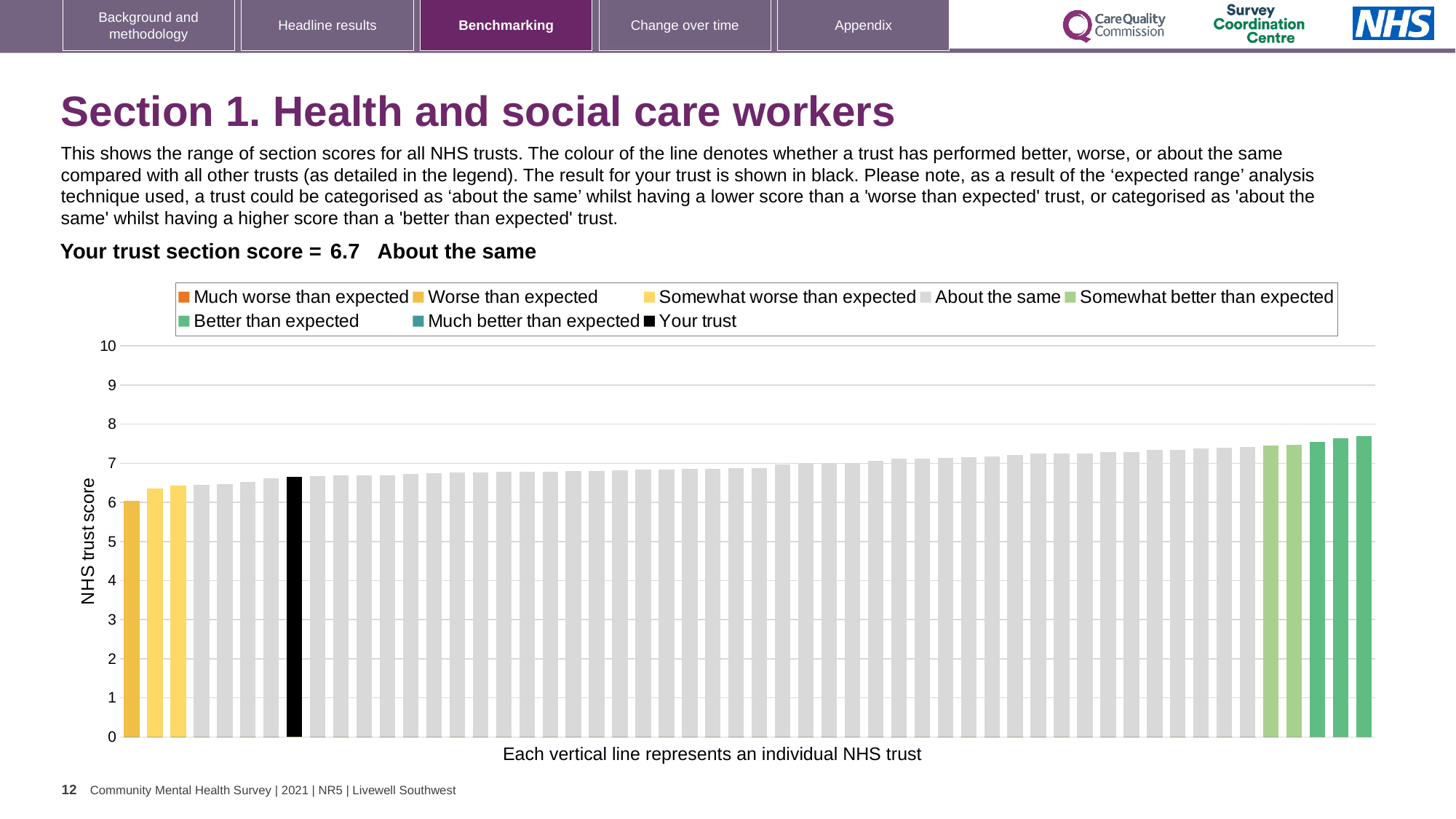
How many bars are coloured as 'Worse than expected' (yellow)? 1 Which category does your trust fall into according to the slide? About the same Do the bar values rise or fall from left to right along the x axis? rise What is the label on the vertical axis of the chart? NHS trust score What is the section score for your trust shown on the slide? 6.7 What kind of chart is shown on the slide? bar chart Is the value for your trust (the black bar) greater or less than 7? less Is the value for your trust (the black bar) greater or less than 6? greater Is the value of the shortest bar greater or less than 7? less How many entries does the chart legend list? 8 What colour is used for the 'Your trust' bar? black